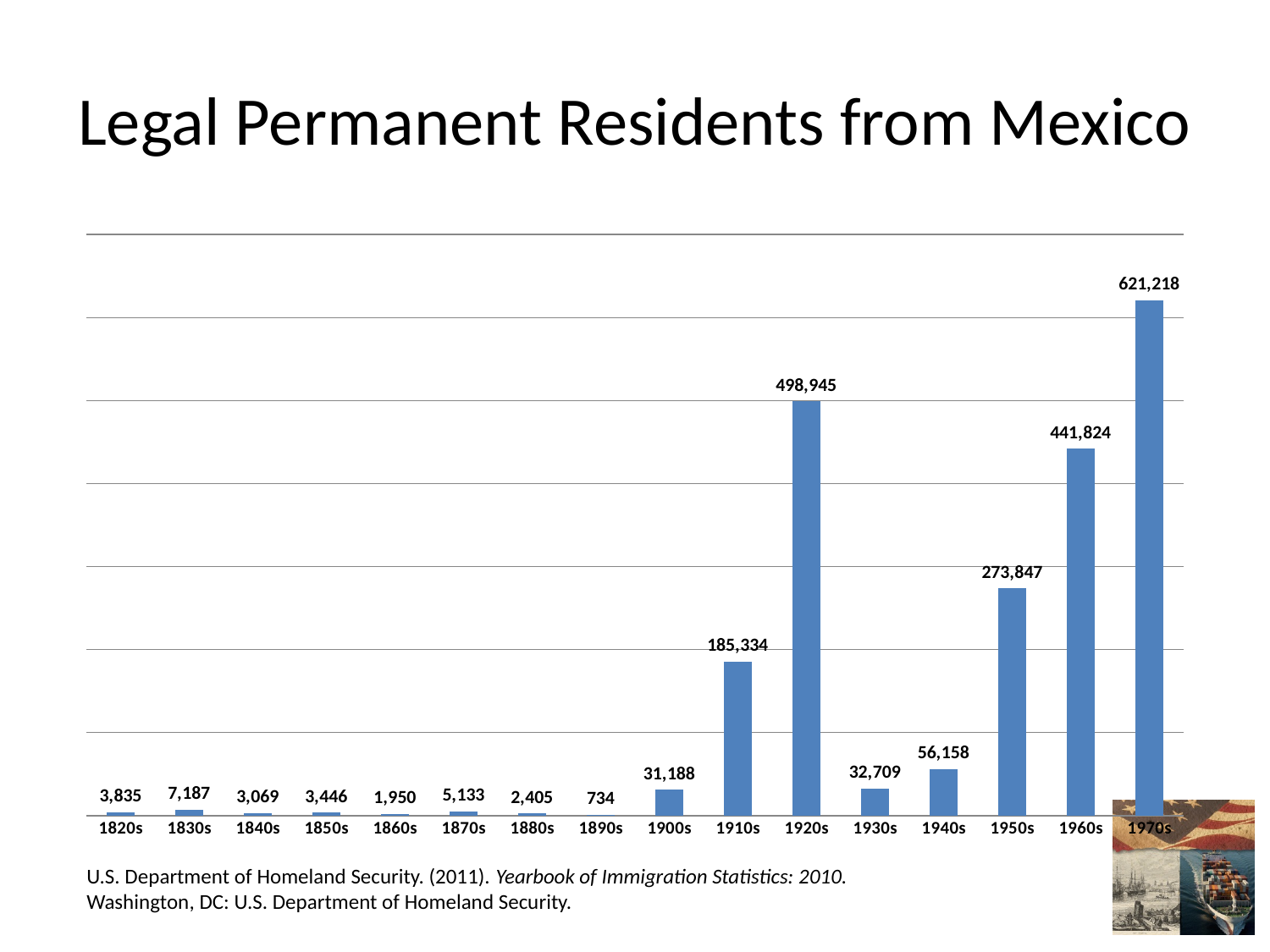
What kind of chart is shown on the slide? Bar chart What is the value for the 1920s? 498,945 What is the difference between the values for the 1970s and the 1960s? 179,394 What is the title of the slide? Legal Permanent Residents from Mexico What is the value for the 1950s? 273,847 Which decade has the highest value? 1970s What is the value for the 1890s? 734 Which decade has the lowest value? 1890s Which is larger, the value for the 1910s or the value for the 1950s? 1950s Do the values generally rise or fall from the 1940s to the 1970s? Rise How many decades are shown on the x axis? 16 What is the difference between the values for the 1940s and the 1930s? 23,449